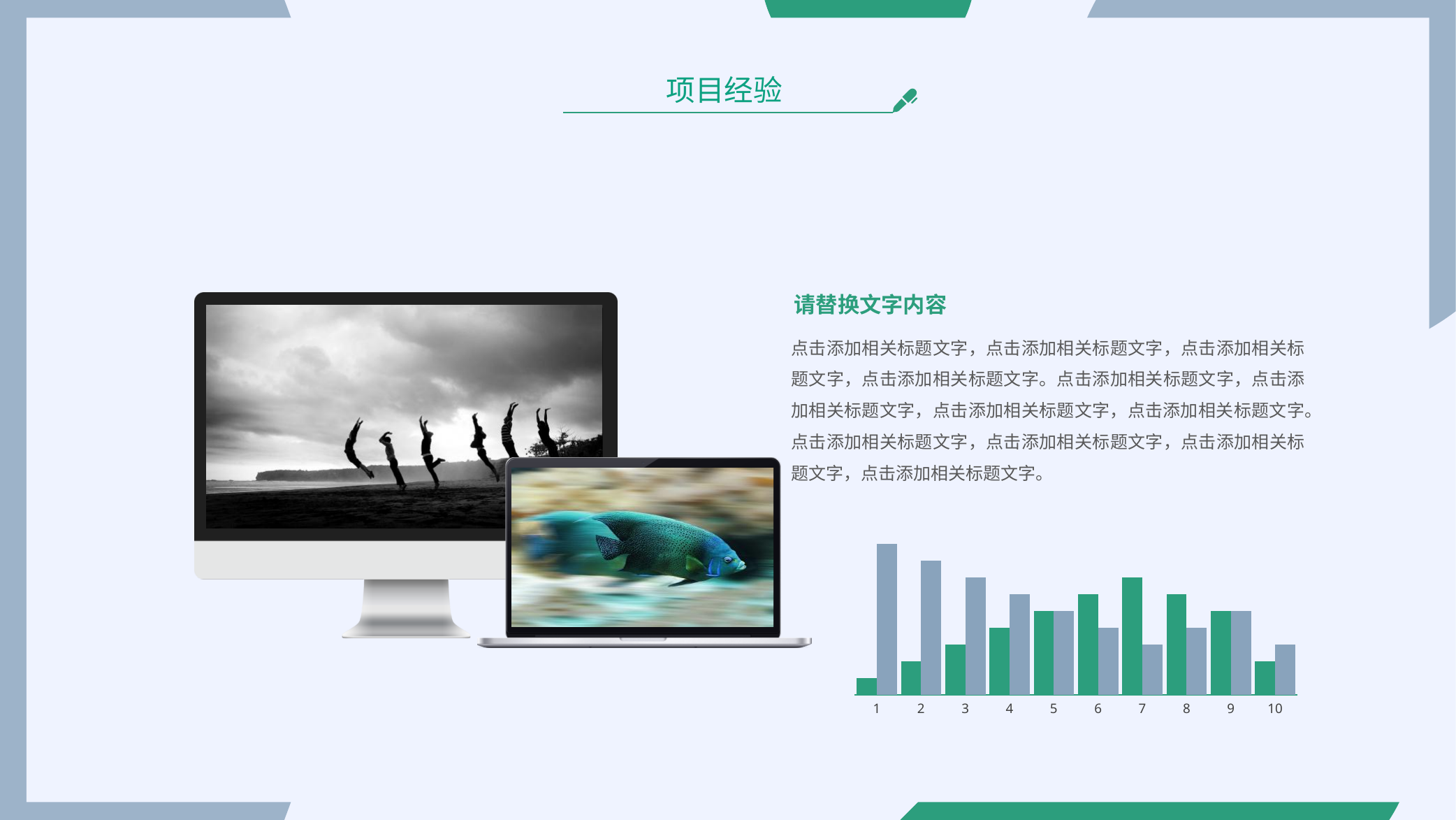
Which category has the taller grey-blue bar, 2 or 10? 2 How many categories are shown on the x axis of the bar chart? 10 What kind of chart is shown at the bottom right of the slide? bar chart At category 1, which bar is taller, the green one or the grey-blue one? grey-blue Which category has the tallest green bar in the bar chart? 7 At category 7, which bar is taller, the green one or the grey-blue one? green Which category has the shortest green bar in the bar chart? 1 How many differently coloured bar series are plotted in the bar chart? 2 Do the grey-blue bars rise or fall from category 1 to category 3? fall Which category has the tallest grey-blue bar in the bar chart? 1